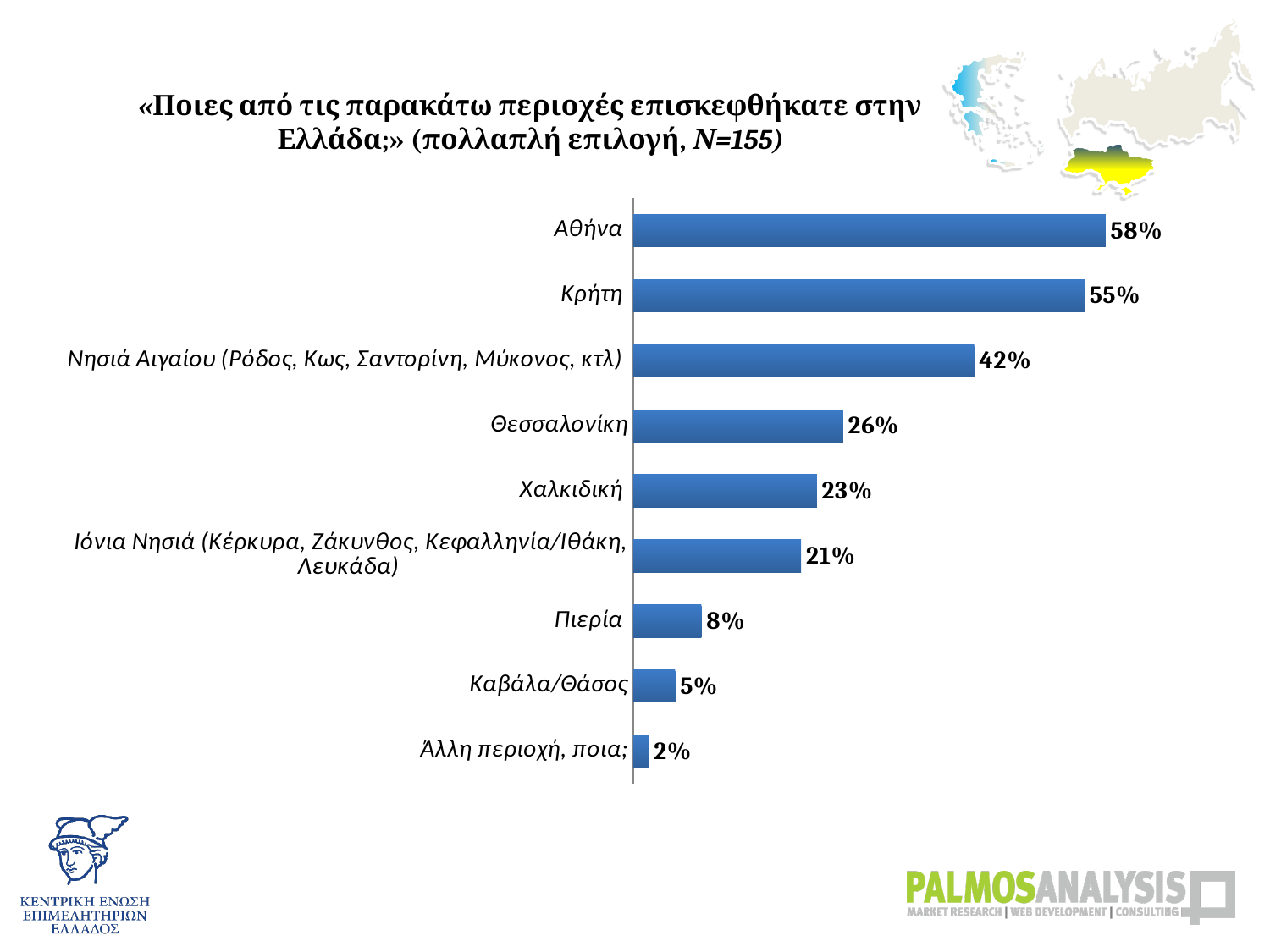
Which is larger, the value for Νησιά Αιγαίου or the value for Ιόνια Νησιά? Νησιά Αιγαίου How many categories are shown in the chart? 9 Which category has the lowest value? Άλλη περιοχή, ποια; What is the value for Καβάλα/Θάσος? 5% What is the difference between the values for Κρήτη and Χαλκιδική? 32% What is the value for Θεσσαλονίκη? 26% Which region has the highest value? Αθήνα What kind of chart is shown on the slide? Bar chart What is the sample size (N) stated in the chart title? N=155 What is the value for Αθήνα? 58% What is the value for Ιόνια Νησιά (Κέρκυρα, Ζάκυνθος, Κεφαλληνία/Ιθάκη, Λευκάδα)? 21% What is the difference between the values for Πιερία and Καβάλα/Θάσος? 3%